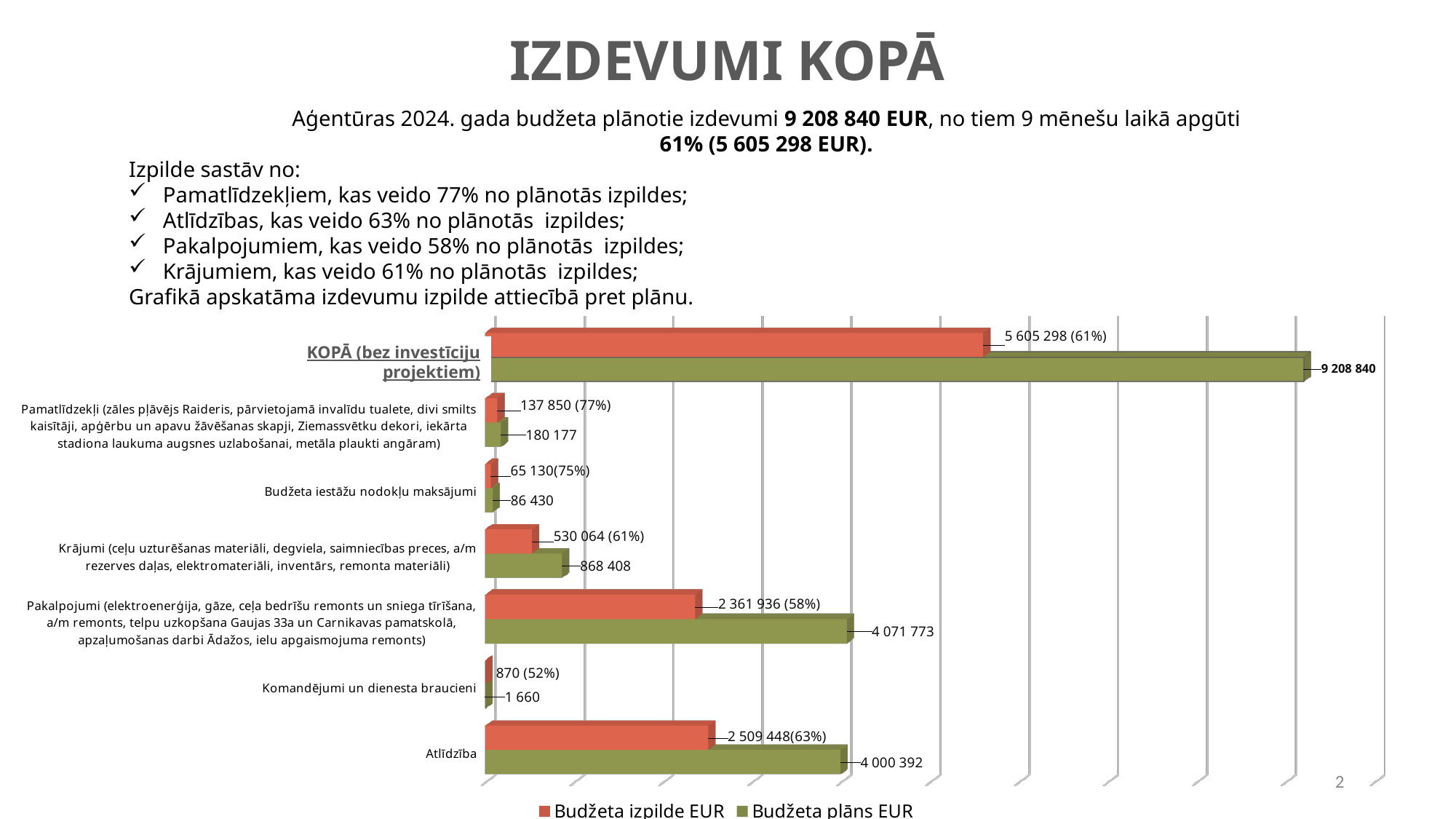
Which is larger: the Budžeta plāns EUR value for Pakalpojumi or for Atlīdzība? Pakalpojumi What is the Budžeta plāns EUR value for Atlīdzība? 4 000 392 Excluding the KOPĀ total, which category has the highest Budžeta plāns EUR value? Pakalpojumi Which category has the lowest Budžeta plāns EUR value? Komandējumi un dienesta braucieni What kind of chart is shown on the slide? Bar chart What are the two series named in the chart legend? Budžeta izpilde EUR and Budžeta plāns EUR What is the Budžeta izpilde EUR data label for KOPĀ (bez investīciju projektiem)? 5 605 298 (61%) How many categories are shown on the chart's vertical axis? 7 How many series does the chart legend list? 2 What is the difference between the Budžeta plāns EUR and Budžeta izpilde EUR values for Atlīdzība? 1 490 944 What is the Budžeta plāns EUR value for KOPĀ (bez investīciju projektiem)? 9 208 840 What is the Budžeta izpilde EUR data label for Komandējumi un dienesta braucieni? 870 (52%)